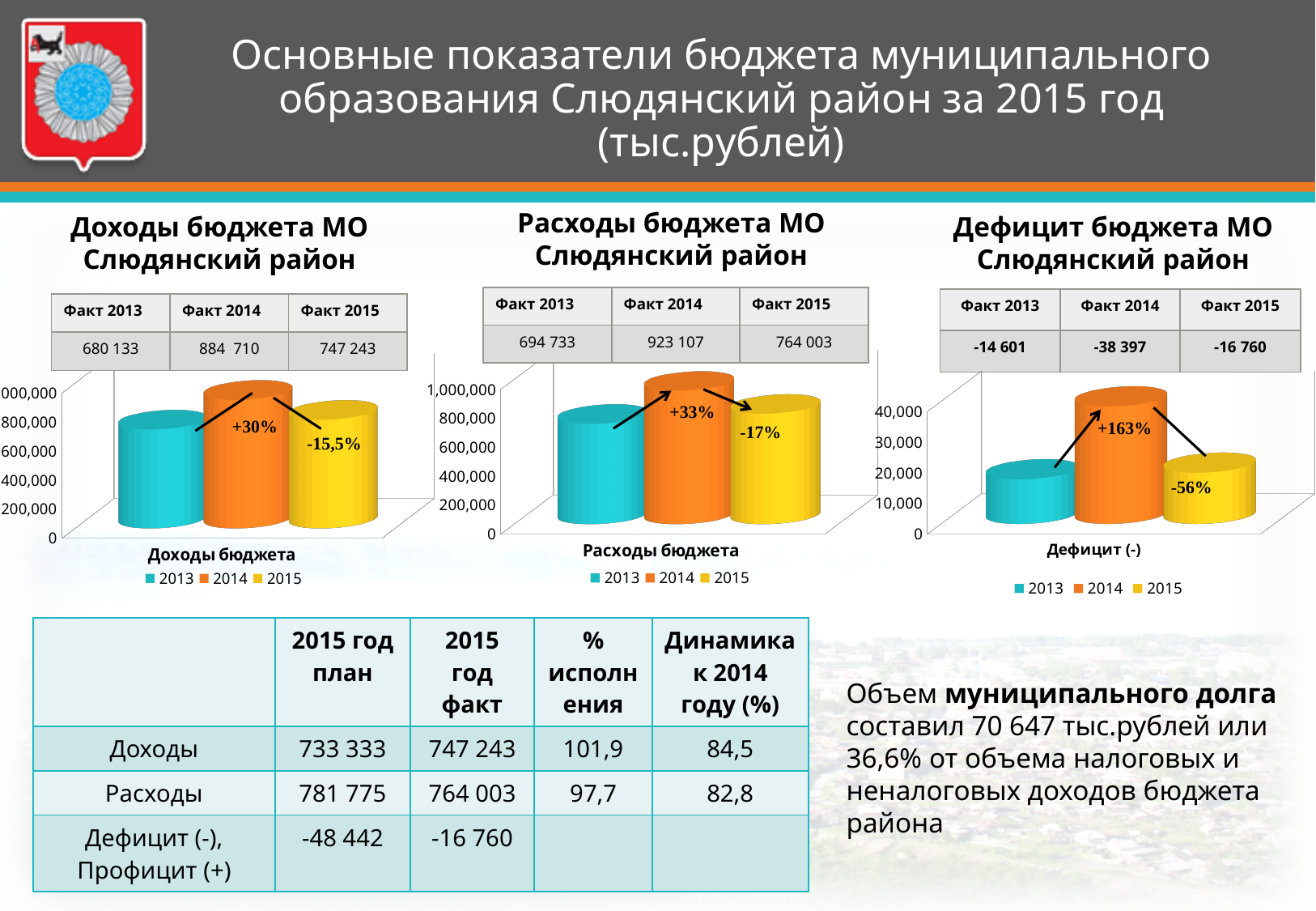
What kind of chart is 'Доходы бюджета МО Слюдянский район'? bar chart In the chart 'Расходы бюджета МО Слюдянский район', is the value for 2014 greater or less than 800,000? greater In the chart 'Дефицит бюджета МО Слюдянский район', what is the value for Факт 2013? -14 601 In the chart 'Расходы бюджета МО Слюдянский район', which year has the lowest value? 2013 In the chart 'Доходы бюджета МО Слюдянский район', what is the difference between the 2014 and 2013 values? 204 577 How many series does the legend of the chart 'Дефицит бюджета МО Слюдянский район' list? 3 In the chart 'Расходы бюджета МО Слюдянский район', what is the value for Факт 2015? 764 003 In the chart 'Дефицит бюджета МО Слюдянский район', which bar is taller, 2013 or 2015? 2015 In the chart 'Доходы бюджета МО Слюдянский район', which year has the highest value? 2014 In the chart 'Расходы бюджета МО Слюдянский район', what is the difference between the 2014 and 2015 values? 159 104 In the chart 'Расходы бюджета МО Слюдянский район', what percentage change is annotated between the 2014 and 2015 bars? -17% In the chart 'Доходы бюджета МО Слюдянский район', what is the value for Факт 2014? 884 710